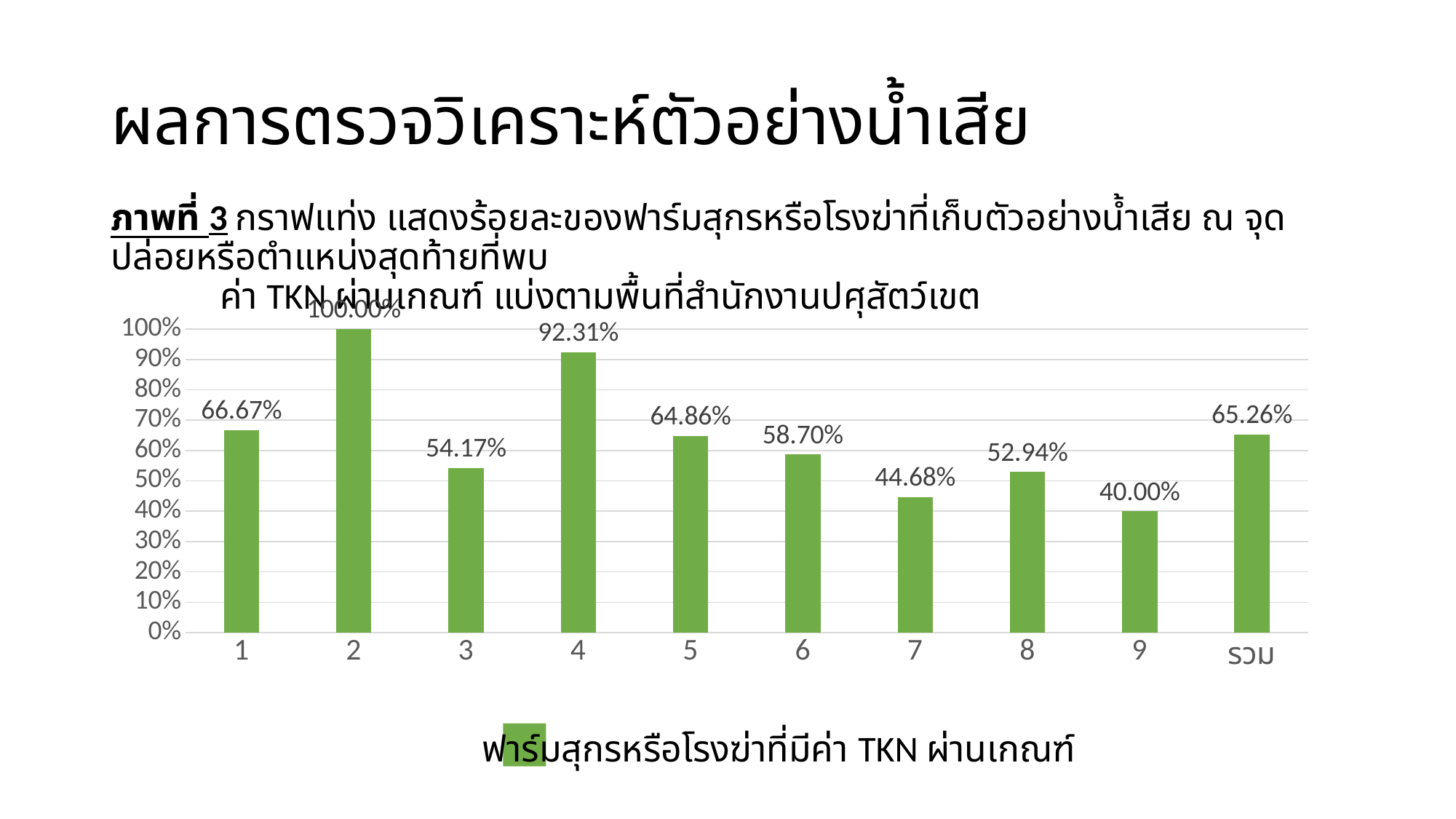
What is the difference between the values for category 2 and category 9? 60.00% Is the value for category 6 greater or less than 50%? greater What is the value for category 7? 44.68% What is the difference between the values for category 1 and category 3? 12.50% What is the value for the รวม category? 65.26% How many categories are shown on the x axis? 10 What is the value for category 4? 92.31% How many series does the legend list? 1 What type of chart is shown on the slide? bar chart Which category has the highest value? 2 Which is larger, the value for category 5 or the value for category 8? category 5 Which category has the lowest value? 9